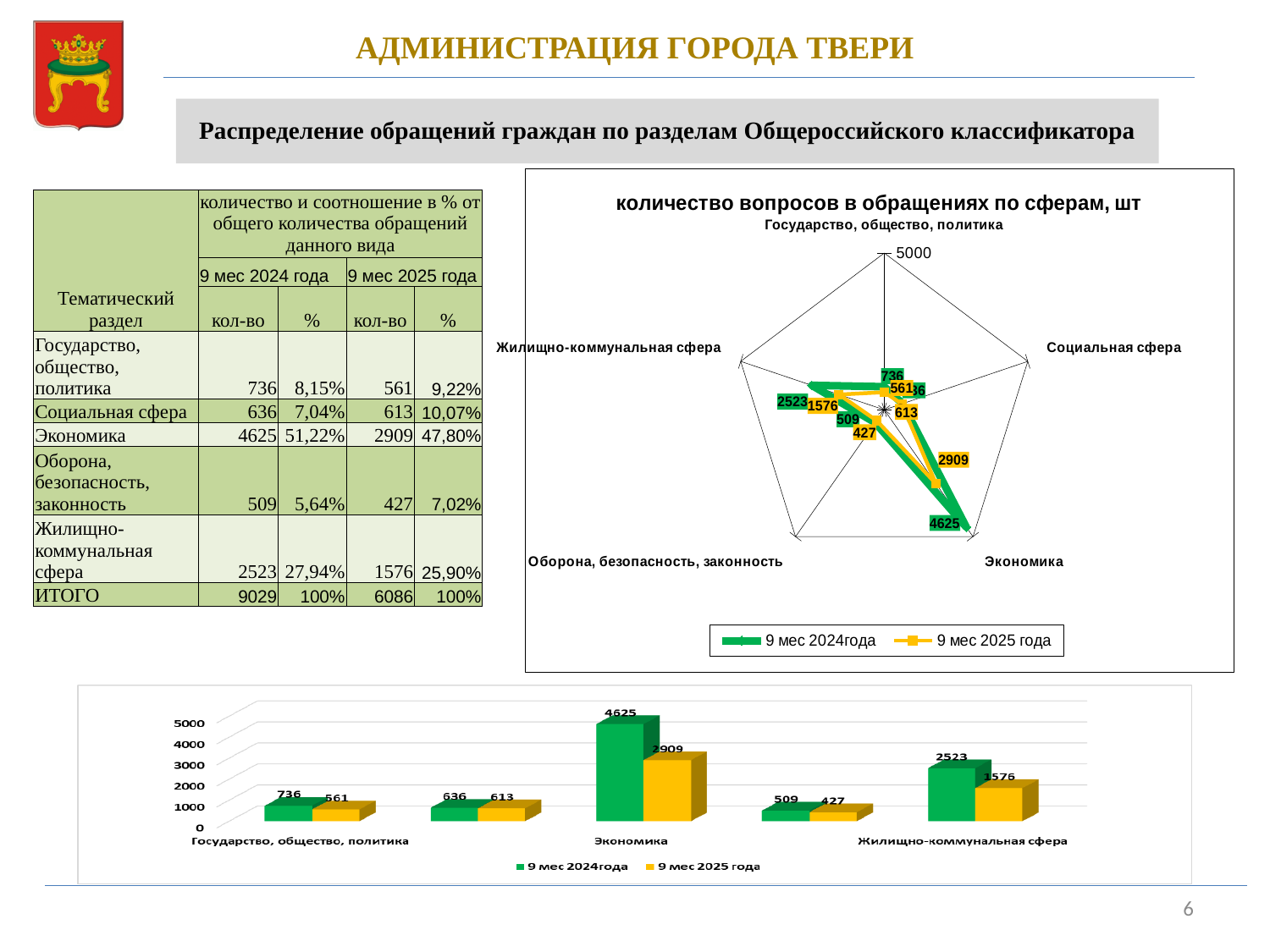
In the radar chart 'количество вопросов в обращениях по сферам, шт', what is the value for Экономика for 9 мес 2024года? 4625 In the radar chart 'количество вопросов в обращениях по сферам, шт', what is the value for Экономика for 9 мес 2025 года? 2909 In the bar chart at the bottom of the slide, what is the value for Государство, общество, политика for 9 мес 2024года? 736 In the radar chart 'количество вопросов в обращениях по сферам, шт', how many series does the legend list? 2 What kind of chart is shown at the bottom of the slide? bar chart In the bar chart at the bottom of the slide, what is the difference between the 9 мес 2024года and 9 мес 2025 года values for Экономика? 1716 In the radar chart 'количество вопросов в обращениях по сферам, шт', which category has the highest value for 9 мес 2024года? Экономика In the radar chart 'количество вопросов в обращениях по сферам, шт', how many axes (categories) are there? 5 In the radar chart 'количество вопросов в обращениях по сферам, шт', what is the maximum value shown on the axis scale? 5000 In the bar chart at the bottom of the slide, which is larger for Жилищно-коммунальная сфера: the 9 мес 2024года value or the 9 мес 2025 года value? 9 мес 2024года In the bar chart at the bottom of the slide, is the 9 мес 2024года value for Экономика greater or less than 4000? greater In the bar chart at the bottom of the slide, what is the value for Жилищно-коммунальная сфера for 9 мес 2025 года? 1576